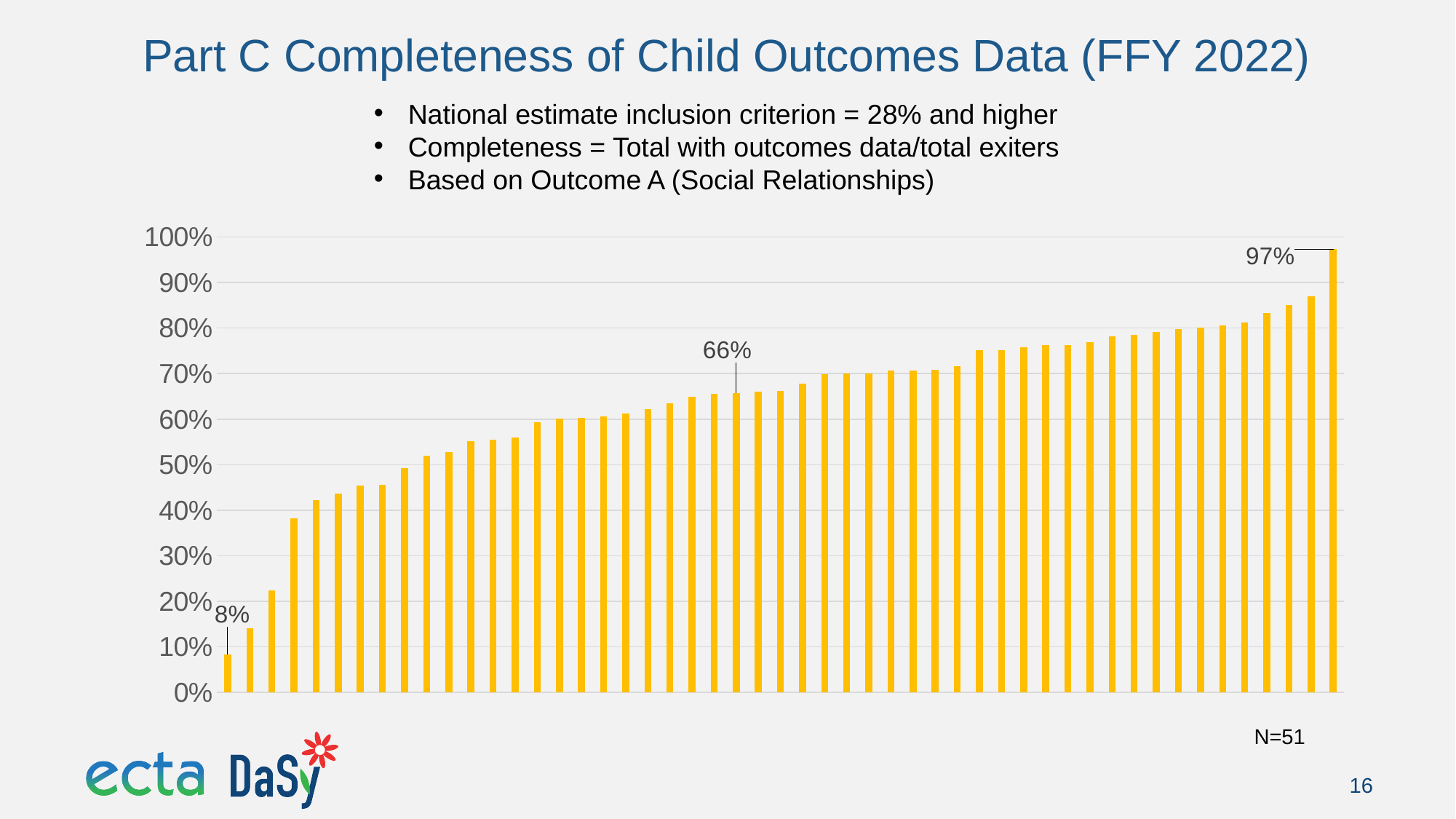
Is the value of the fourth bar from the left greater or less than 30%? greater Do the bar values rise or fall from left to right across the chart? rise What is the difference between the highest labeled value (97%) and the lowest labeled value (8%)? 89% What is the highest completeness value labeled on the chart? 97% Which is larger, the leftmost bar or the rightmost bar? the rightmost bar What kind of chart is shown on the slide? bar chart Is the value of the second bar from the left greater or less than 20%? less Is the value of the second bar from the right greater or less than 90%? less What value is labeled on the bar in the middle of the chart? 66% How many states or entities are included in the chart, according to the N shown on the slide? 51 What is the title of the chart on the slide? Part C Completeness of Child Outcomes Data (FFY 2022) What is the lowest completeness value labeled on the chart? 8%